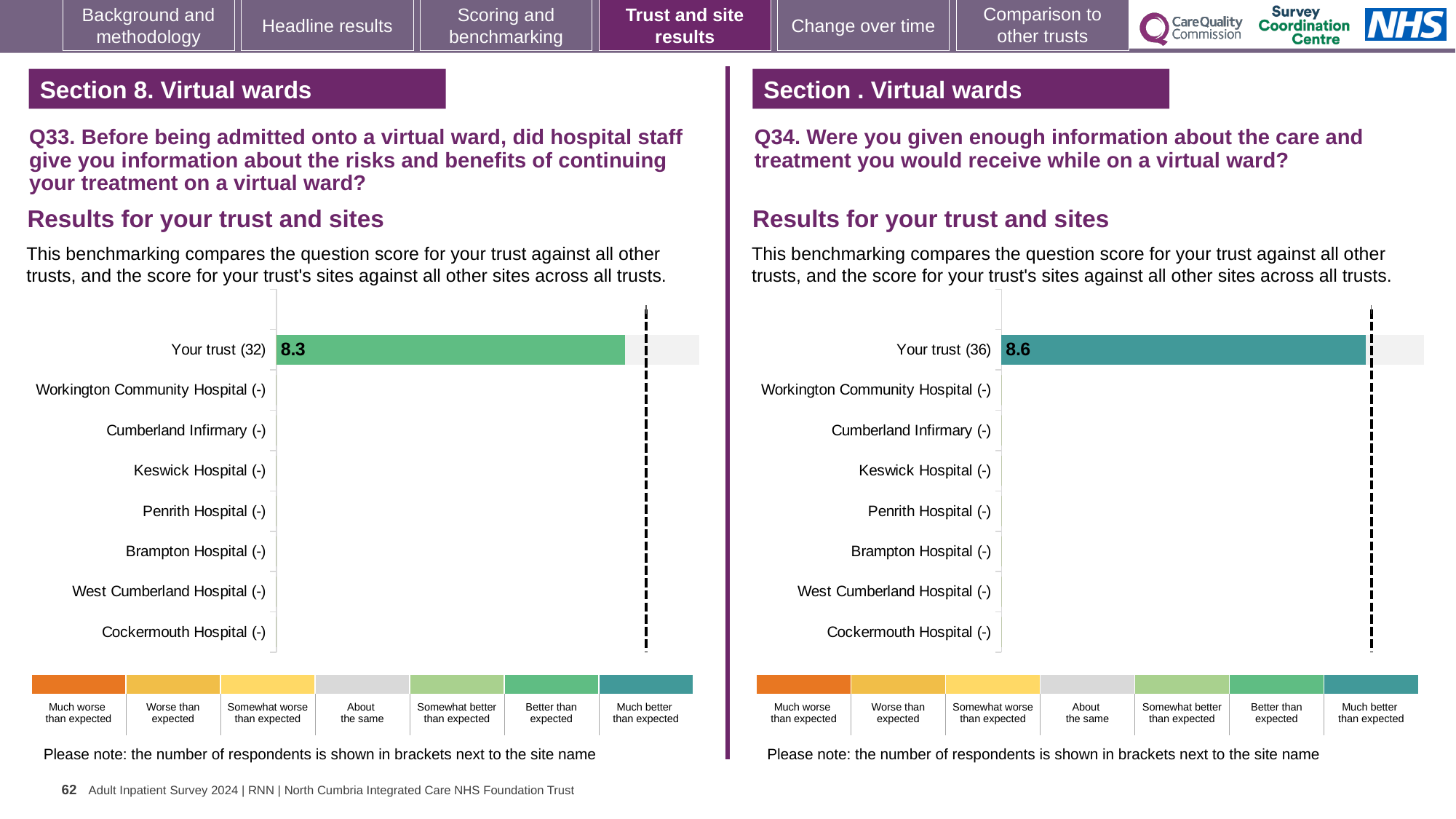
What is the difference between the Your trust score in the Q34 chart on the right and the Your trust score in the Q33 chart on the left? 0.3 How many categories (rows) are listed on the y axis of the Q34 chart on the right? 8 In the Q33 chart on the left, which benchmark category does the colour of the Your trust bar correspond to in the legend? Better than expected In the Q34 chart on the right, what is the score for Your trust? 8.6 In the Q33 chart on the left, which category has the highest score? Your trust (32) In the Q34 chart on the right, how many respondents are shown in brackets for Your trust? 36 In the Q33 chart on the left, how many respondents are shown in brackets for Your trust? 32 In the Q33 chart on the left, what is the score for Your trust? 8.3 How many categories (rows) are listed on the y axis of the Q33 chart on the left? 8 Which is larger: the Your trust score in the Q33 chart on the left or the Your trust score in the Q34 chart on the right? Q34 chart (8.6) In the Q34 chart on the right, which benchmark category does the colour of the Your trust bar correspond to in the legend? Much better than expected What kind of chart is the Q33 chart on the left? Bar chart